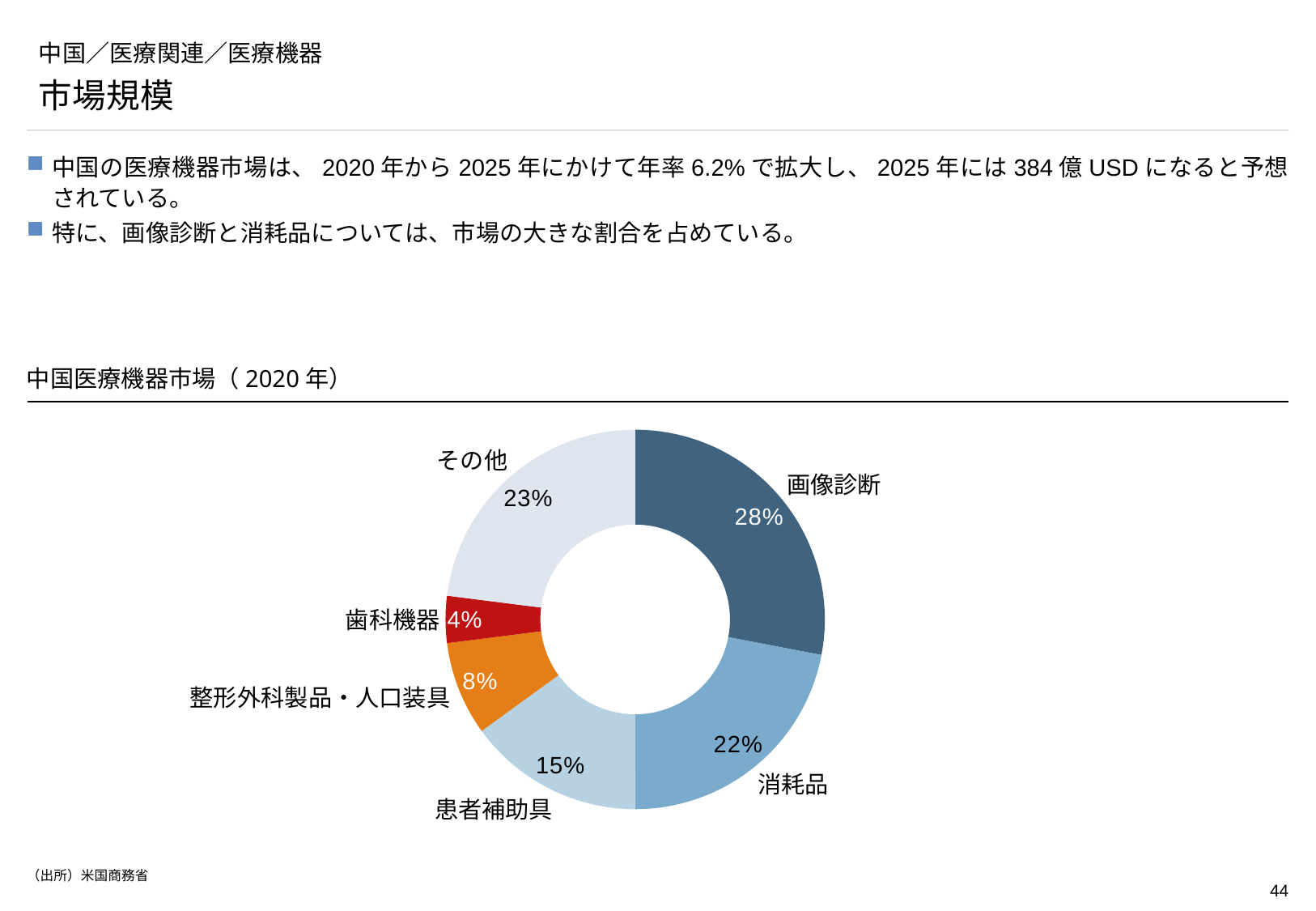
What is the difference in percentage points between 画像診断 and 消耗品? 6 percentage points How many categories are shown in the chart? 6 What share does 整形外科製品・人口装具 have in the chart? 8% Which is larger, the share for 患者補助具 or the share for 整形外科製品・人口装具? 患者補助具 What is the value for 患者補助具 in the chart? 15% What percentage is shown for 消耗品 in the chart? 22% What share is shown for その他? 23% Which category has the largest share in the chart? 画像診断 What type of chart is shown on the slide? Doughnut (pie) chart What percentage is labelled for 歯科機器? 4% What share of the 中国医療機器市場（2020年） chart does 画像診断 account for? 28% Which category has the smallest share in the chart? 歯科機器